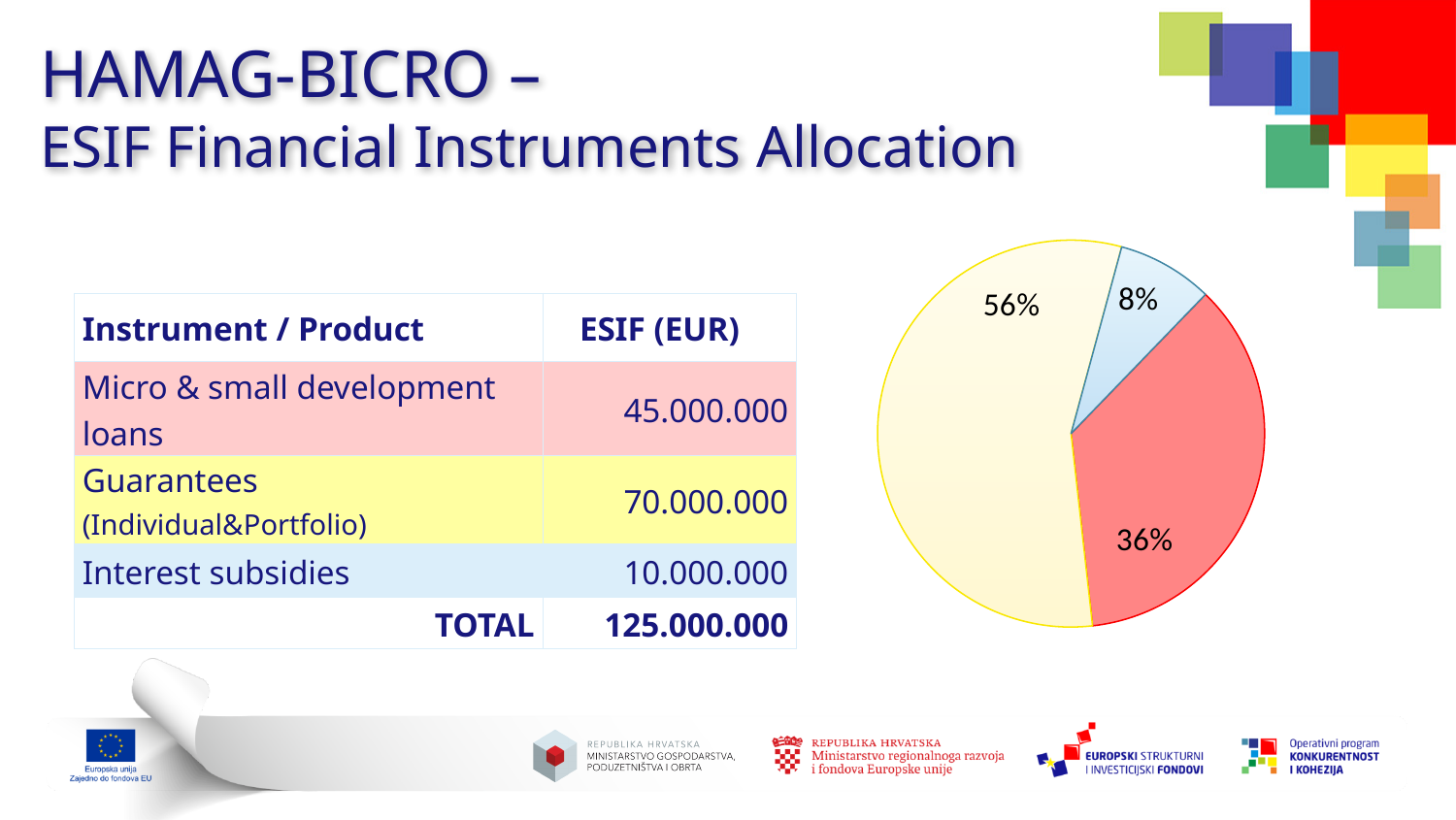
Which colour is the slice of the pie chart that matches the Guarantees row of the table? yellow What percentage is shown on the smallest slice of the pie chart? 8% What kind of chart is shown on the slide? pie chart What percentage is shown on the light blue slice of the pie chart? 8% How many slices does the pie chart have? 3 Does the pie chart have a legend? No What share of the pie does the slice matching the Interest subsidies row of the table represent? 8% What percentage is shown on the red slice of the pie chart? 36% What percentage is shown on the largest slice of the pie chart? 56% What percentage is shown on the yellow slice of the pie chart? 56% Which slice of the pie chart is larger, the red one or the light blue one? the red one What is the difference in percentage points between the yellow slice and the red slice of the pie chart? 20